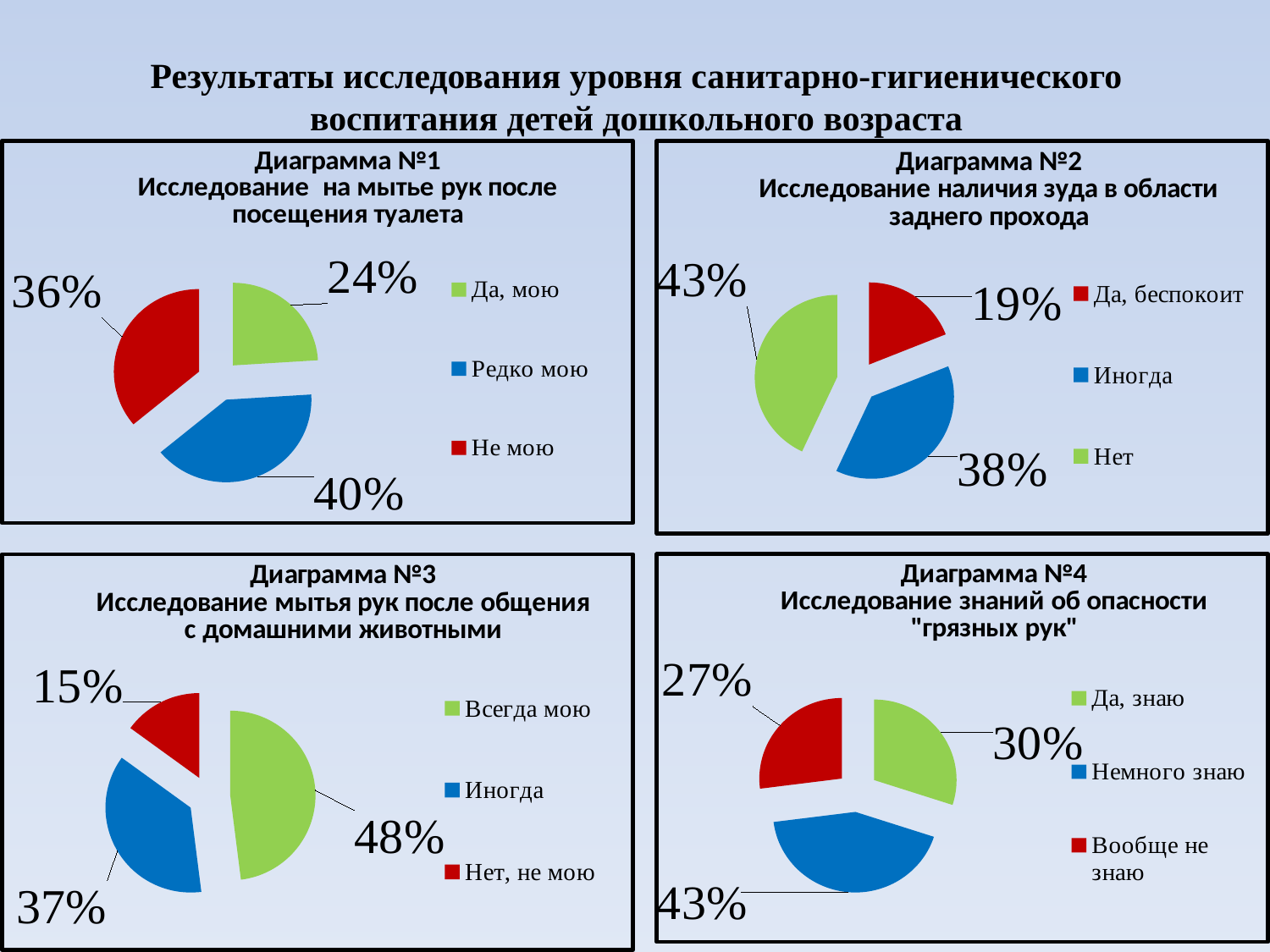
In Диаграмма №4, what share corresponds to "Вообще не знаю"? 27% In Диаграмма №3, what share of children answered "Всегда мою"? 48% What type of chart is Диаграмма №3? Pie chart In Диаграмма №4, which answer has the largest share? Немного знаю In Диаграмма №2, what share corresponds to "Да, беспокоит"? 19% In Диаграмма №1, which answer has the smallest share? Да, мою In Диаграмма №1, what share of children answered "Редко мою"? 40% How many slices does the pie in Диаграмма №4 have? 3 In Диаграмма №2, which answer has the largest share? Нет In Диаграмма №3, what is the difference between the shares for "Иногда" and "Нет, не мою"? 22% In Диаграмма №1, what is the difference between the shares for "Не мою" and "Да, мою"? 12% In Диаграмма №2, which is larger: the share for "Иногда" or the share for "Да, беспокоит"? Иногда